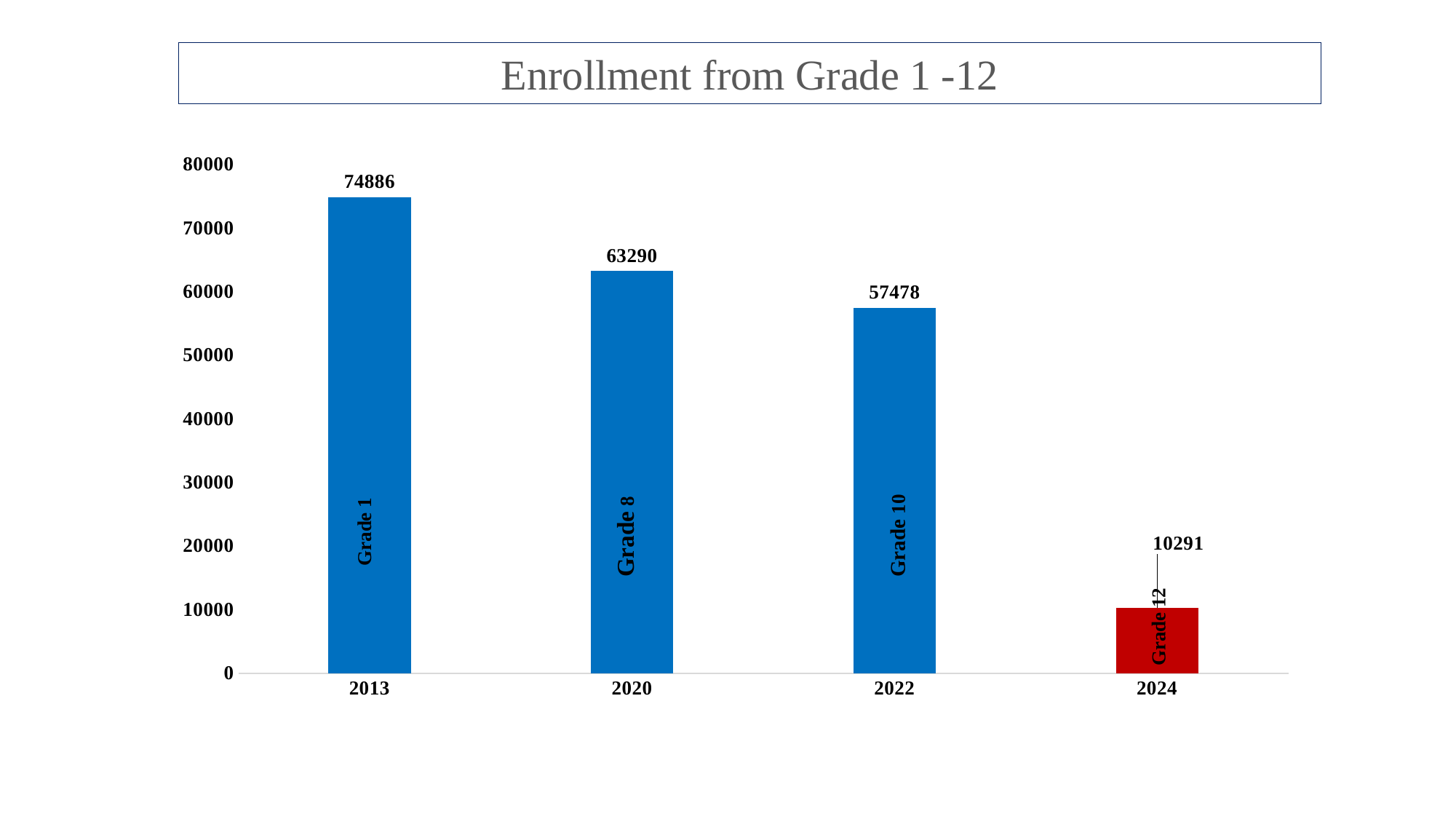
What is the enrollment value for 2022? 57478 What is the enrollment value for 2020? 63290 Which is larger, the enrollment in 2020 or in 2022? 2020 What is the difference between the enrollment in 2020 and in 2022? 5812 What is the difference between the enrollment in 2013 and in 2024? 64595 How many years are shown on the x axis? 4 Which year has the highest enrollment? 2013 Do the enrollment values rise or fall from 2013 to 2024? Fall What is the enrollment value for 2013? 74886 Which year has the lowest enrollment? 2024 What kind of chart is shown on the slide? Bar chart What is the enrollment value for 2024? 10291